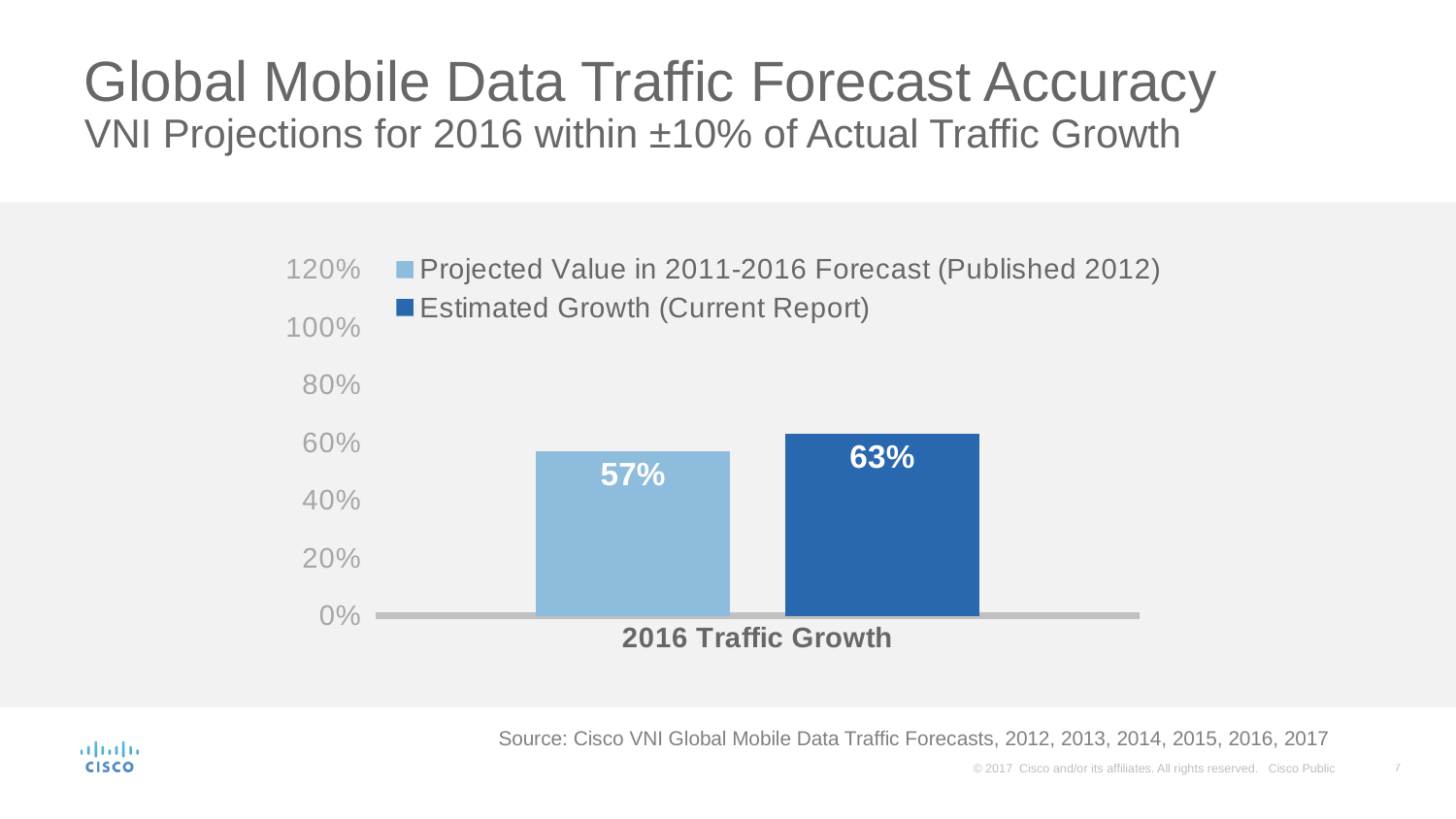
What is the category label on the x axis? 2016 Traffic Growth What is the value for Estimated Growth (Current Report) for 2016 Traffic Growth? 63% Which series has the higher value for 2016 Traffic Growth? Estimated Growth (Current Report) Is the value for Projected Value in 2011-2016 Forecast (Published 2012) greater or less than 60%? less What kind of chart is shown on the slide? bar chart What is the value for Projected Value in 2011-2016 Forecast (Published 2012) for 2016 Traffic Growth? 57% How many categories are shown on the x axis? 1 Is the Projected Value in 2011-2016 Forecast (Published 2012) larger or smaller than the Estimated Growth (Current Report)? smaller Which series has the lower value for 2016 Traffic Growth? Projected Value in 2011-2016 Forecast (Published 2012) Is the value for Estimated Growth (Current Report) greater or less than 60%? greater How many series does the legend list? 2 What is the difference between the Estimated Growth (Current Report) value and the Projected Value in 2011-2016 Forecast (Published 2012) value? 6%